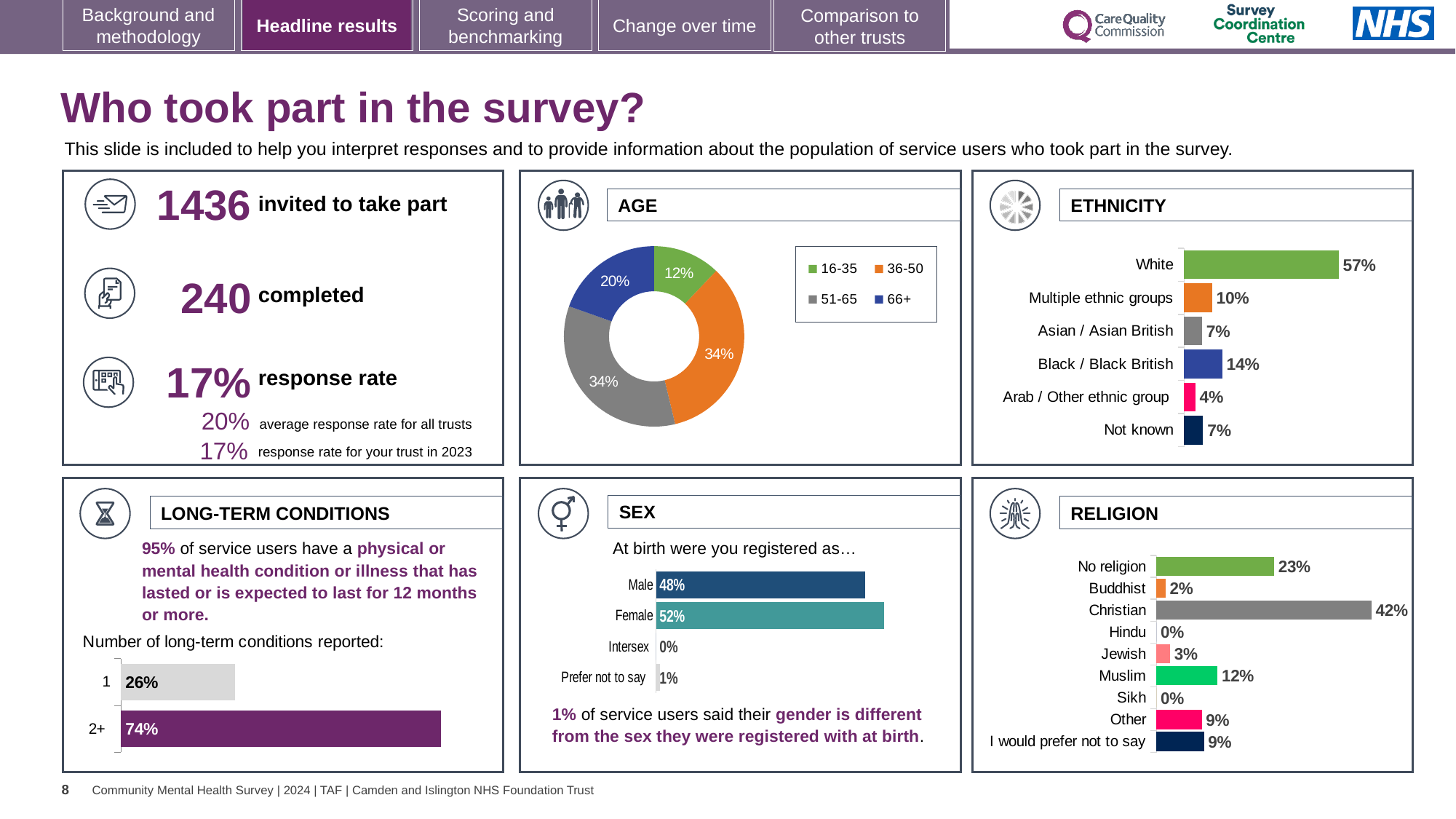
In the AGE chart, which age group has the smallest share? 16-35 How many categories are shown in the RELIGION chart? 9 In the LONG-TERM CONDITIONS chart, what percentage reported 2+ long-term conditions? 74% What kind of chart is the AGE chart? Donut (pie) chart In the ETHNICITY chart, what is the value for Black / Black British? 14% In the ETHNICITY chart, what is the difference between White and Multiple ethnic groups? 47% In the SEX chart, which is larger, Male or Female? Female How many age groups does the legend of the AGE chart list? 4 In the RELIGION chart, which category has the highest value? Christian In the AGE chart, what share of respondents were aged 66+? 20% In the ETHNICITY chart, which category has the lowest value? Arab / Other ethnic group In the ETHNICITY chart, which category has the highest value? White